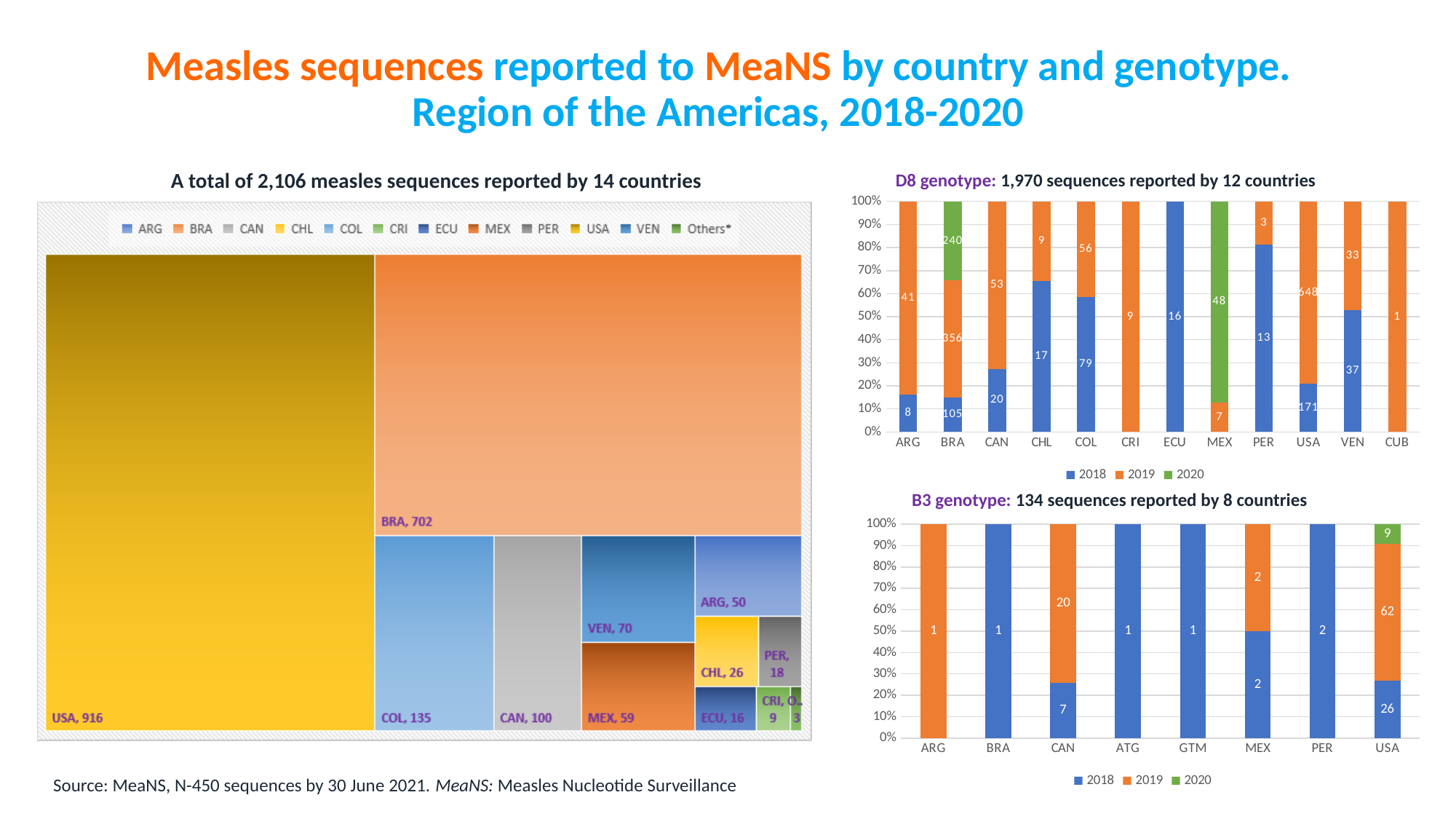
What kind of chart is the B3 genotype chart? Stacked bar chart In the treemap chart on the left, how many measles sequences were reported by USA? 916 In the B3 genotype chart, how many countries are shown on the x axis? 8 In the treemap chart on the left, what is the difference between the sequences reported by BRA and COL? 567 In the treemap chart on the left, which country reported the most measles sequences? USA In the D8 genotype chart, how many sequences did USA report in 2019? 648 In the D8 genotype chart, how many sequences did BRA report in 2020? 240 In the D8 genotype chart, how many series does the legend list? 3 In the D8 genotype chart, which is larger for COL: the 2018 value or the 2019 value? 2018 In the B3 genotype chart, what is the total number of sequences reported by USA across all years? 97 In the B3 genotype chart, how many sequences did CAN report in 2019? 20 In the D8 genotype chart, how many countries are shown on the x axis? 12